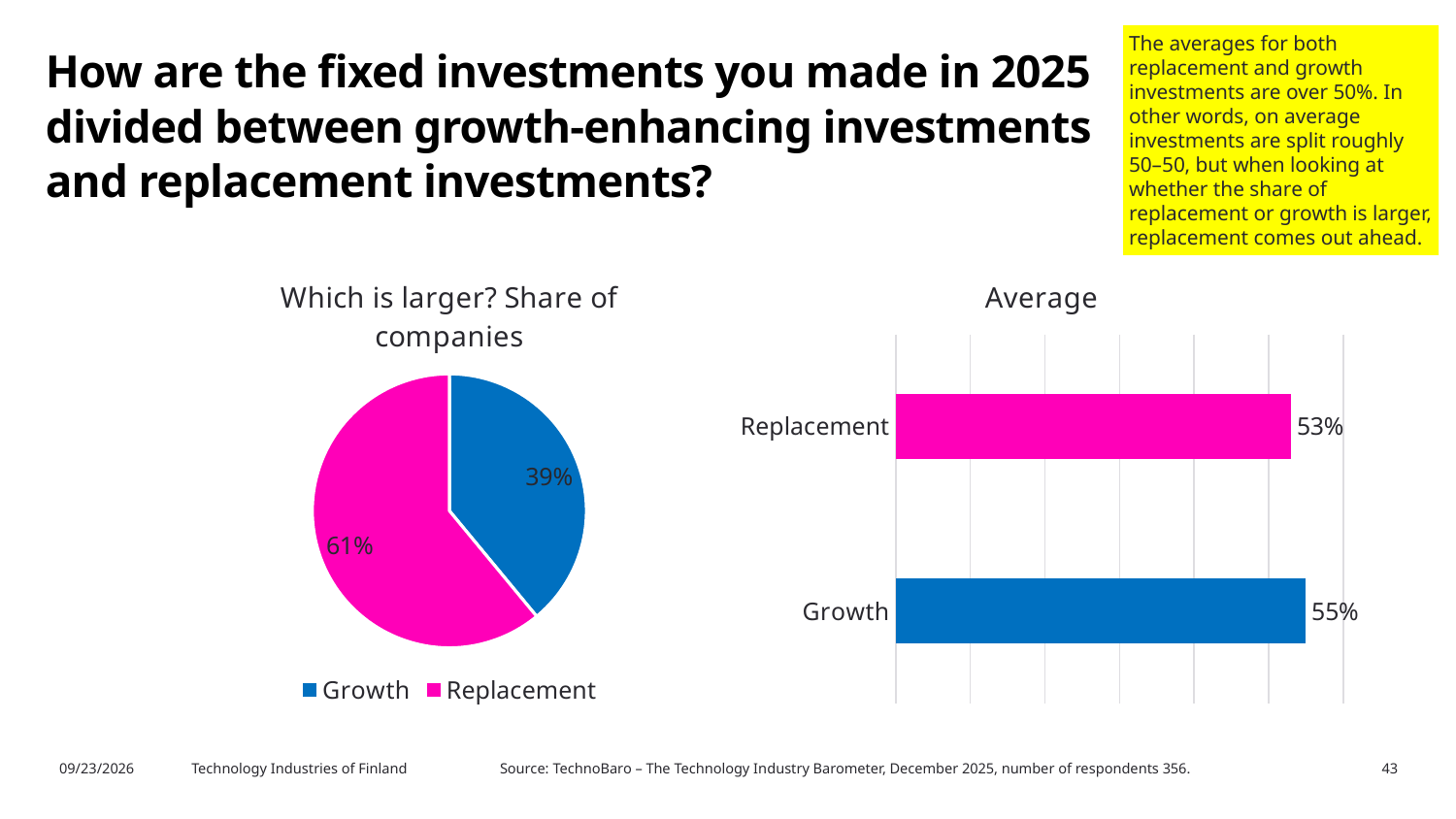
What kind of chart is the 'Which is larger? Share of companies' chart? Pie chart In the 'Average' chart, what is the value for Growth? 55% In the 'Which is larger? Share of companies' pie chart, which slice is the largest? Replacement What kind of chart is the 'Average' chart? Bar chart In the 'Which is larger? Share of companies' pie chart, what share of companies is shown for Replacement? 61% In the 'Average' chart, what is the difference in percentage points between Growth and Replacement? 2 percentage points In the 'Which is larger? Share of companies' pie chart, what share of companies is shown for Growth? 39% How many categories are shown in the 'Average' chart? 2 In the 'Which is larger? Share of companies' pie chart, what is the difference in percentage points between the Replacement and Growth slices? 22 percentage points In the 'Average' chart, what is the value for Replacement? 53% In the 'Average' chart, which category has the higher value, Growth or Replacement? Growth In the 'Which is larger? Share of companies' pie chart, how many entries does the legend list? 2